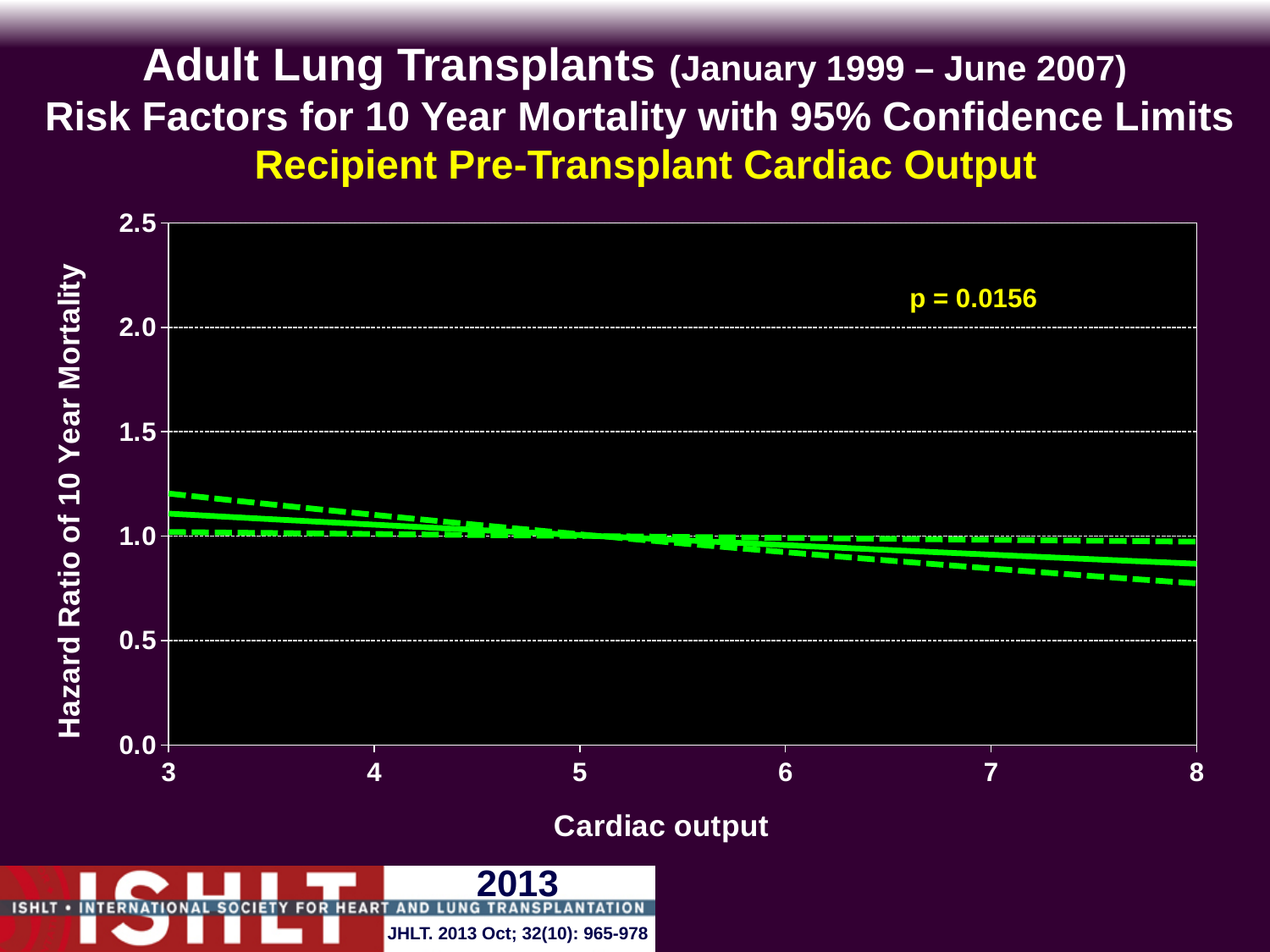
Which has the larger hazard ratio: a cardiac output of 3 or a cardiac output of 8? 3 What kind of chart is shown on the slide? line chart Is the upper 95% confidence limit at a cardiac output of 3 greater or less than 1.5? less Is the lower 95% confidence limit at a cardiac output of 8 greater or less than 0.5? greater Is the hazard ratio at a cardiac output of 8 greater or less than 1.0? less What is the label of the x axis? Cardiac output What p-value is printed on the chart? p = 0.0156 Does the hazard ratio of 10 year mortality rise or fall as cardiac output increases from 3 to 8? fall How many lines are plotted on the chart (the estimate plus its confidence limits)? 3